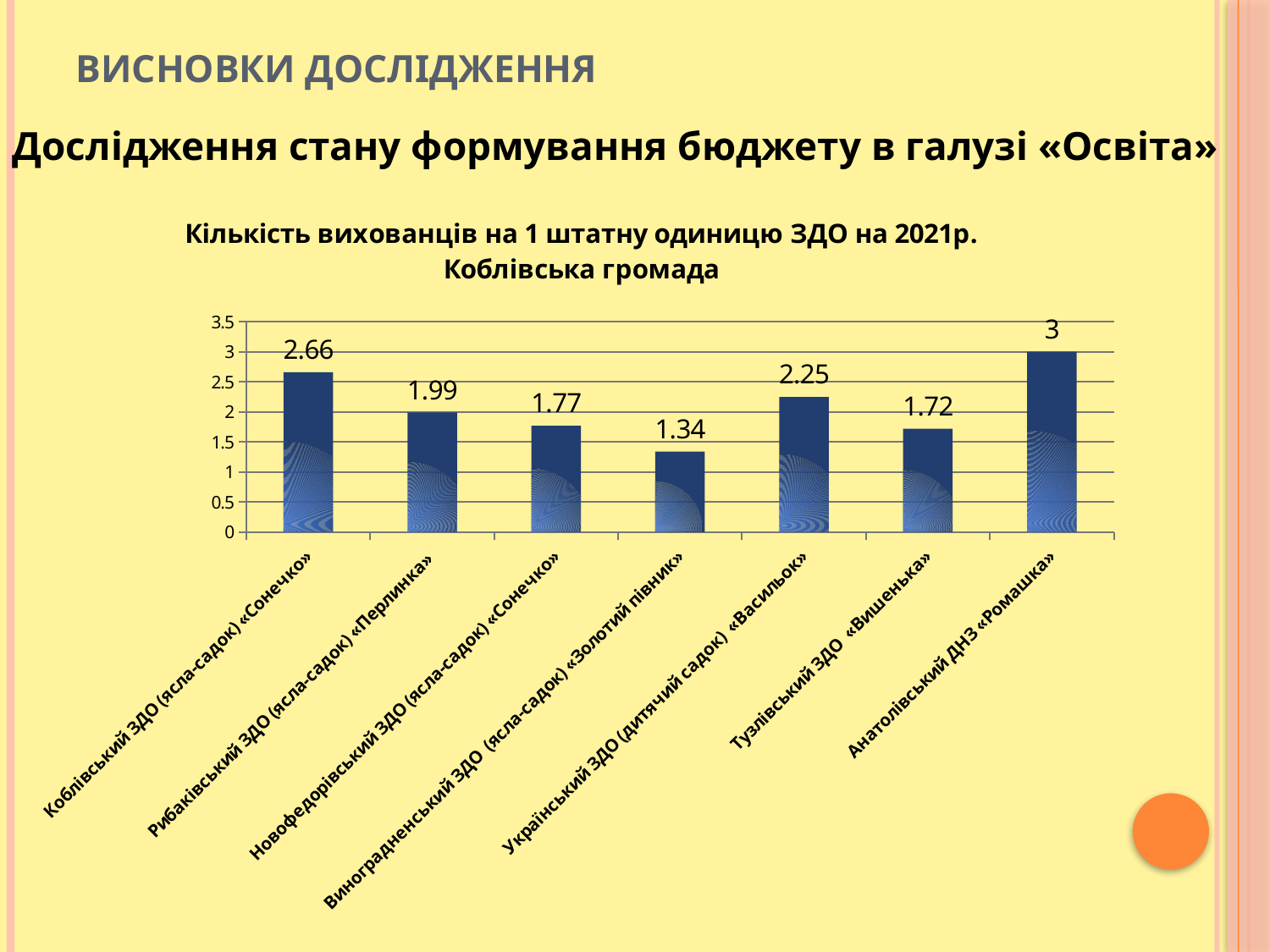
Is the value for Український ЗДО (дитячий садок) «Васильок» greater or less than 2? greater What is the value for Тузлівський ЗДО «Вишенька»? 1.72 Which institution has the highest value in the chart? Анатолівський ДНЗ «Ромашка» What is the difference between the values for Анатолівський ДНЗ «Ромашка» and Виноградненський ЗДО (ясла-садок) «Золотий півник»? 1.66 What type of chart is shown on the slide? bar chart What is the value for Коблівський ЗДО (ясла-садок) «Сонечко»? 2.66 What is the title of the chart? Кількість вихованців на 1 штатну одиницю ЗДО на 2021р. Коблівська громада Which institution has the lowest value in the chart? Виноградненський ЗДО (ясла-садок) «Золотий півник» Which has a larger value: Рибаківський ЗДО (ясла-садок) «Перлинка» or Новофедорівський ЗДО (ясла-садок) «Сонечко»? Рибаківський ЗДО (ясла-садок) «Перлинка» How many categories (institutions) are plotted in the chart? 7 What is the value for Виноградненський ЗДО (ясла-садок) «Золотий півник»? 1.34 What is the value for Український ЗДО (дитячий садок) «Васильок»? 2.25